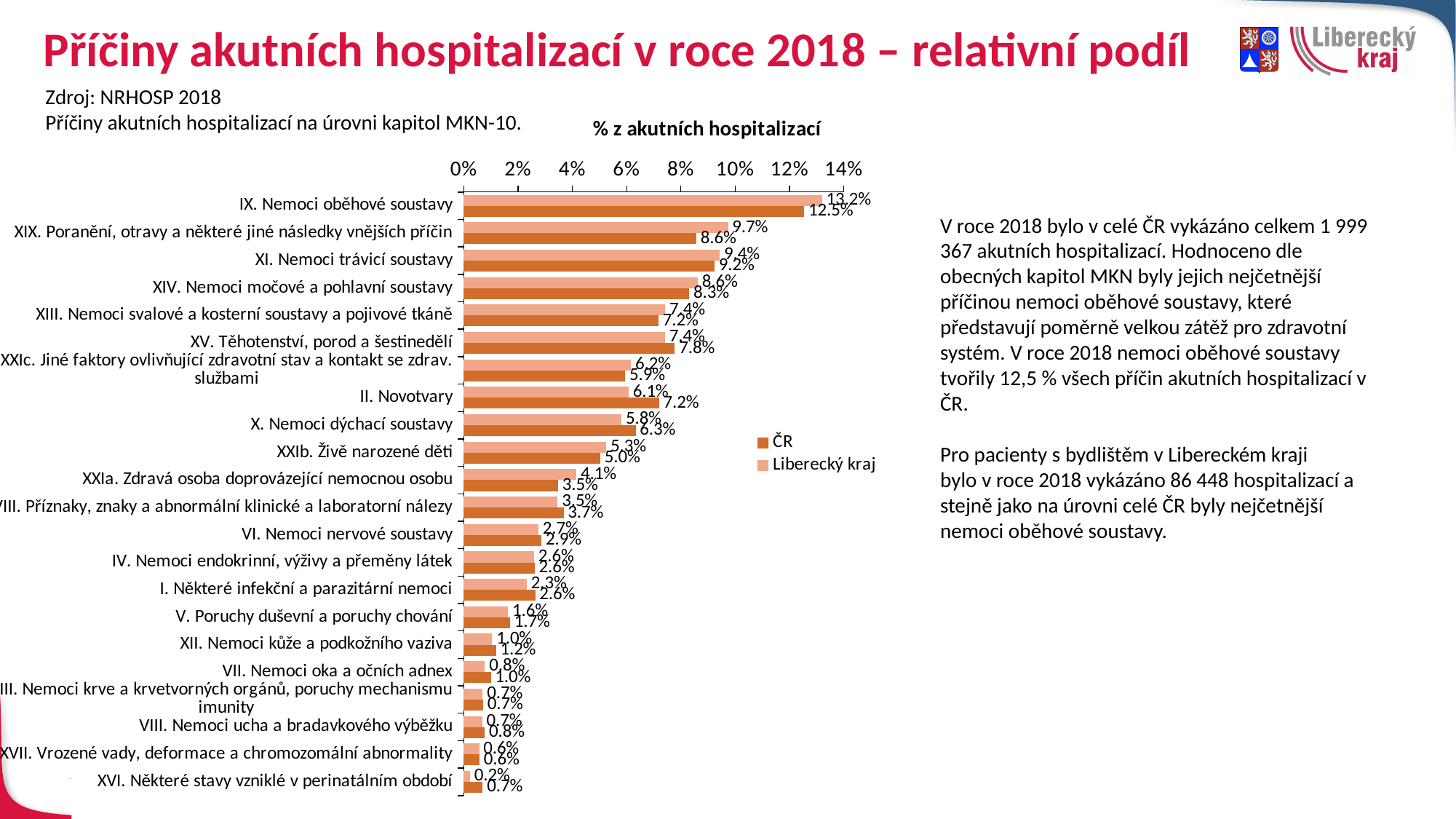
What is the value for Liberecký kraj for XIX. Poranění, otravy a některé jiné následky vnějších příčin? 9.7% What is the value for ČR for II. Novotvary? 7.2% What is the value for Liberecký kraj for IX. Nemoci oběhové soustavy? 13.2% What is the title of the chart? % z akutních hospitalizací What is the value for ČR for IX. Nemoci oběhové soustavy? 12.5% What is the difference between the Liberecký kraj and ČR values for XIX. Poranění, otravy a některé jiné následky vnějších příčin? 1.1% Which category has the highest value for ČR? IX. Nemoci oběhové soustavy How many series does the legend list? 2 Which category has the lowest value for Liberecký kraj? XVI. Některé stavy vzniklé v perinatálním období What type of chart is shown on the slide? bar chart How many categories are shown on the chart? 22 For II. Novotvary, which is larger: the ČR value or the Liberecký kraj value? ČR